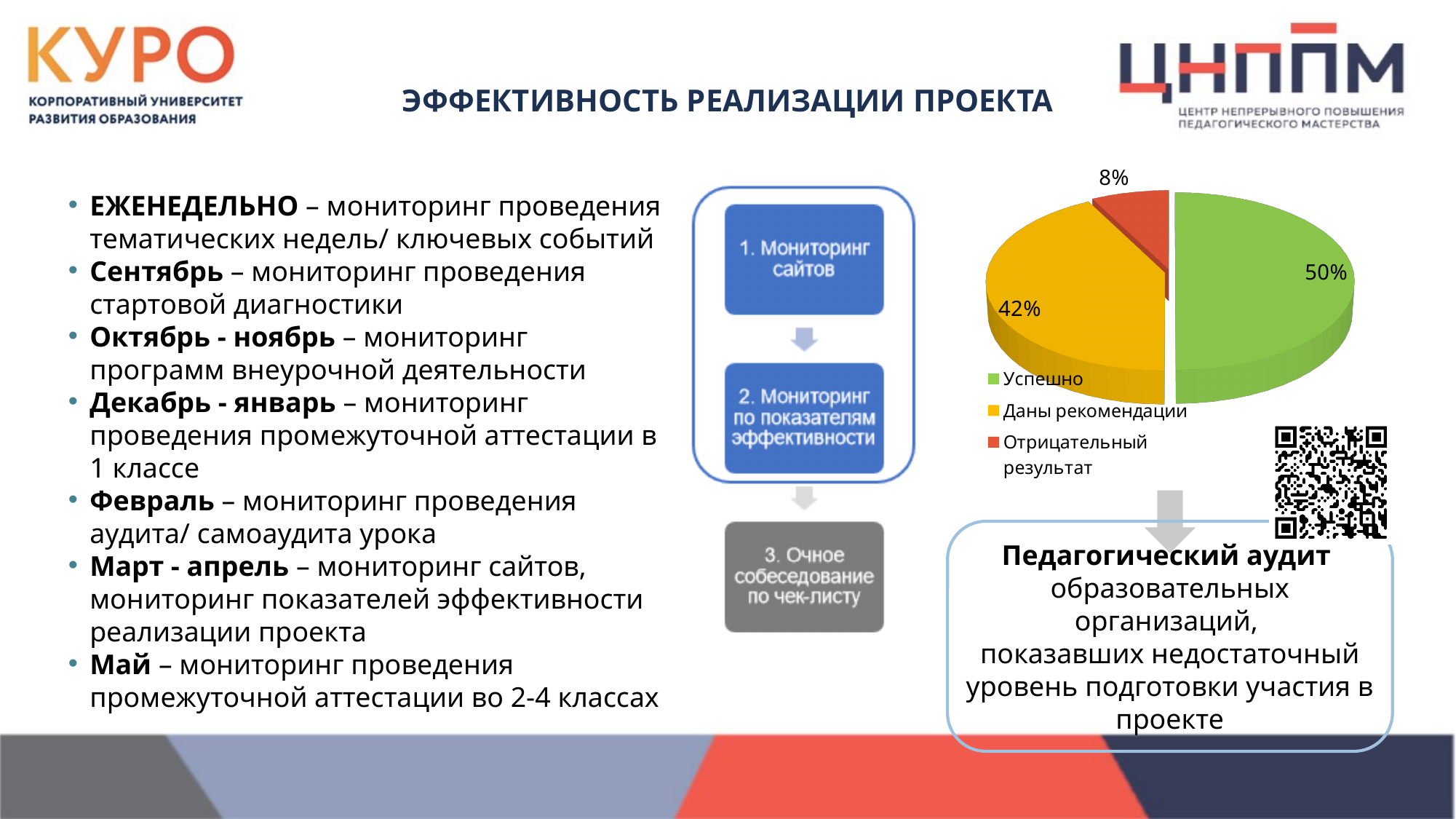
What share of the pie chart is labelled "Даны рекомендации"? 42% Which category has the largest slice in the pie chart? Успешно What share of the pie chart is labelled "Отрицательный результат"? 8% What is the difference in percentage points between the "Даны рекомендации" slice and the "Отрицательный результат" slice? 34 What is the difference in percentage points between the "Успешно" slice and the "Даны рекомендации" slice? 8 What kind of chart is shown on the slide? Pie chart Which slice is larger: "Даны рекомендации" or "Отрицательный результат"? Даны рекомендации What colour is the "Отрицательный результат" slice in the pie chart? Red What share of the pie chart is labelled "Успешно"? 50% How many slices does the pie chart have? 3 How many entries does the pie chart's legend list? 3 Which category has the smallest slice in the pie chart? Отрицательный результат